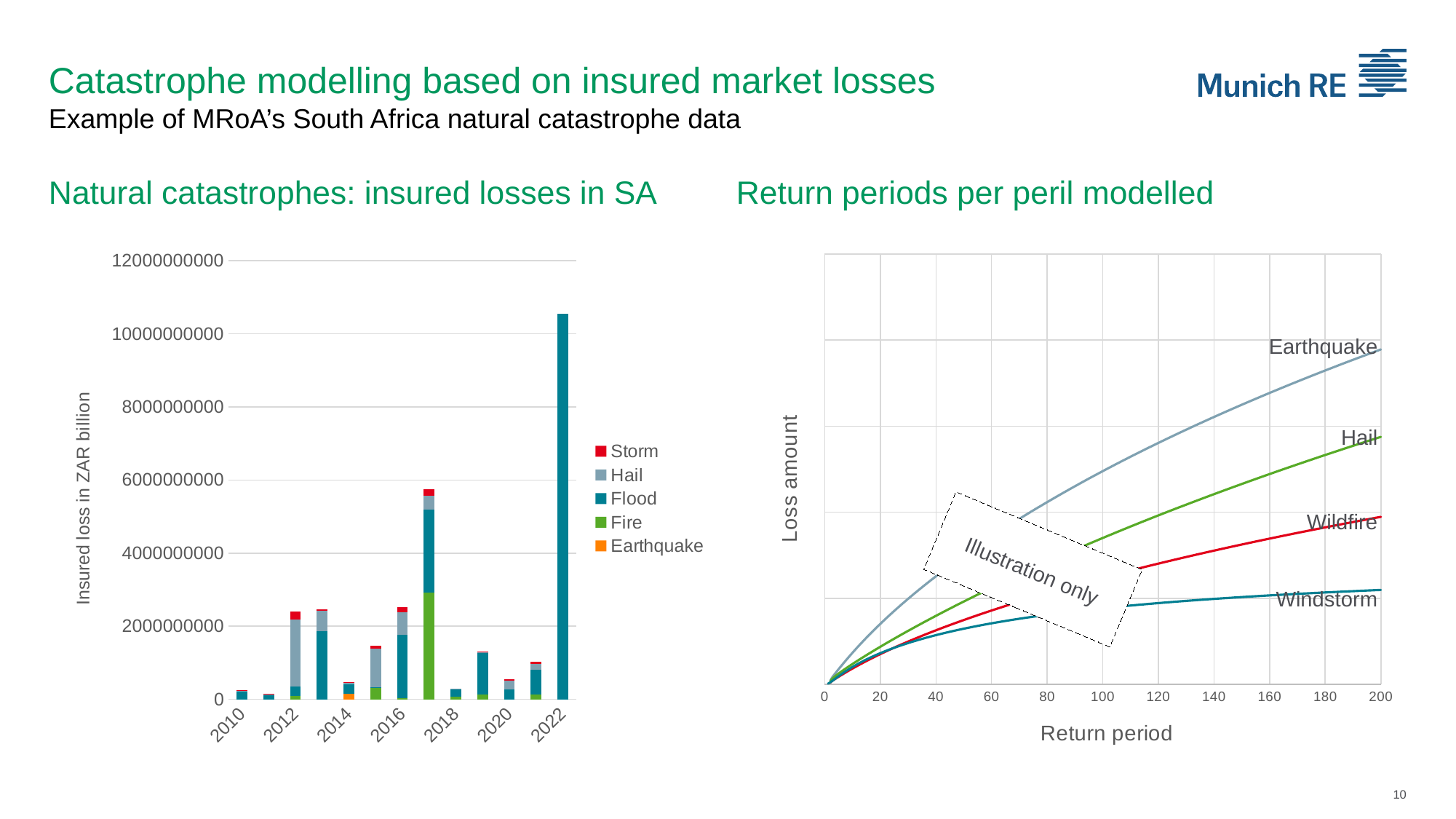
In the 'Natural catastrophes: insured losses in SA' chart, is the total for 2012 greater or less than 2000000000? greater How many series does the legend of the 'Natural catastrophes: insured losses in SA' chart list? 5 In the 'Return periods per peril modelled' chart, which peril has the lowest loss amount at a return period of 200? Windstorm In the 'Return periods per peril modelled' chart, which peril has the highest loss amount at a return period of 200? Earthquake In the 'Natural catastrophes: insured losses in SA' chart, which series is shown in orange? Earthquake What kind of chart is the 'Natural catastrophes: insured losses in SA' chart? Stacked bar chart In the 'Natural catastrophes: insured losses in SA' chart, which year has the larger total insured loss, 2015 or 2016? 2016 In the 'Natural catastrophes: insured losses in SA' chart, is the total for 2017 greater or less than 6000000000? less What kind of chart is the 'Return periods per peril modelled' chart? Line chart How many peril lines are plotted in the 'Return periods per peril modelled' chart? 4 In the 'Natural catastrophes: insured losses in SA' chart, is the total for 2022 greater or less than 10000000000? greater In the 'Natural catastrophes: insured losses in SA' chart, which year has the highest total insured loss? 2022